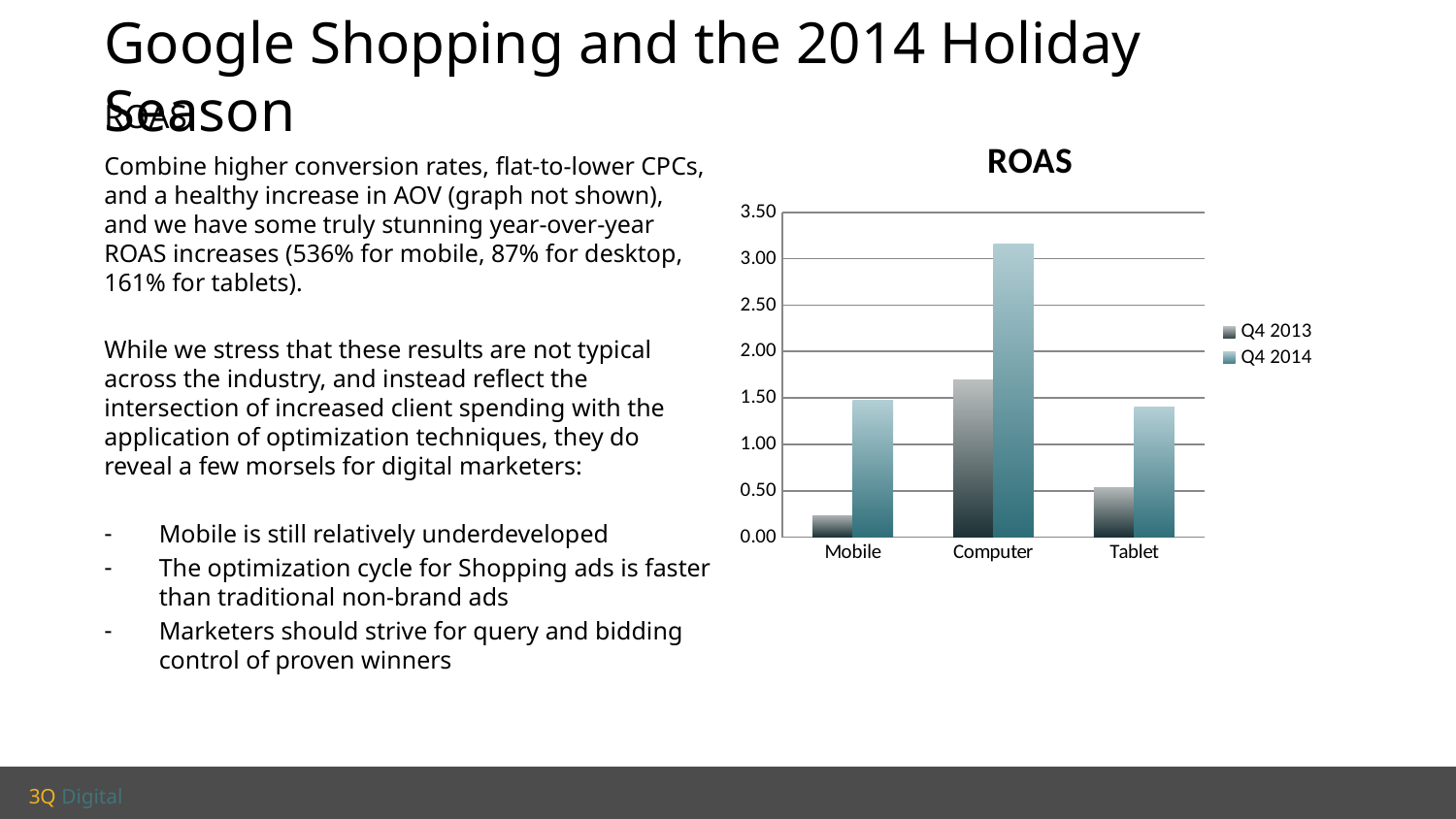
How many categories are shown on the x axis of the chart? 3 Is the Q4 2014 value for Computer greater or less than 3.00? greater Is the Q4 2013 value for Mobile greater or less than 0.50? less Which category has the lowest Q4 2013 value? Mobile Which category has the highest Q4 2014 value? Computer Is the Q4 2014 value for Tablet greater or less than 1.00? greater Which is larger for Computer: the Q4 2013 value or the Q4 2014 value? Q4 2014 What is the title of the chart? ROAS How many series does the chart legend list? 2 What type of chart is shown on the slide? bar chart Which series are listed in the chart legend? Q4 2013 and Q4 2014 Which category has the highest Q4 2013 value? Computer